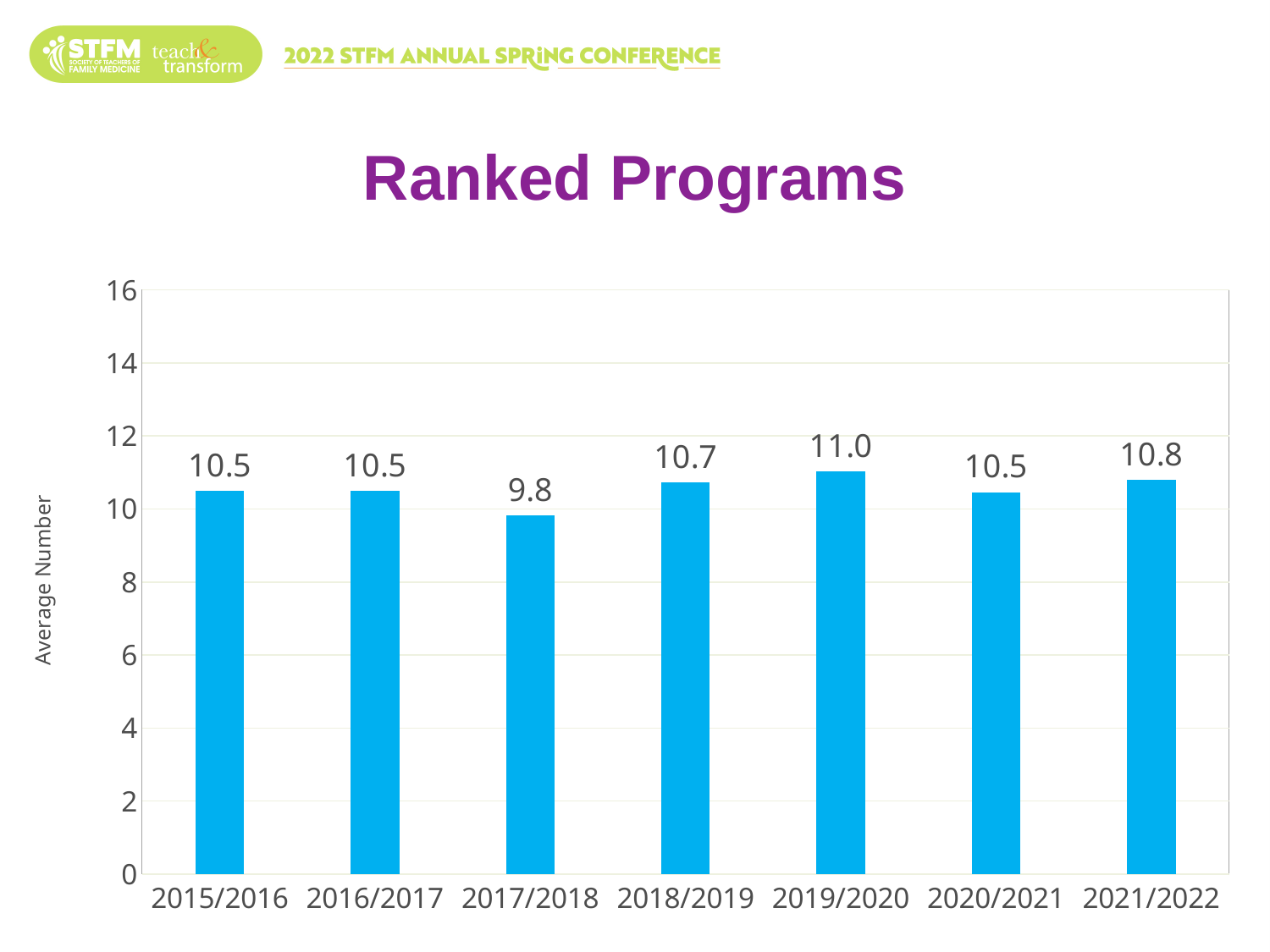
What is the average number of ranked programs for 2017/2018? 9.8 What is the average number of ranked programs for 2019/2020? 11.0 What kind of chart is shown on the slide? bar chart Is the value for 2017/2018 greater or less than 10? less What is the difference between the values for 2021/2022 and 2020/2021? 0.3 Which year has the highest average number of ranked programs? 2019/2020 What is the average number of ranked programs for 2021/2022? 10.8 Which is larger, the value for 2018/2019 or the value for 2017/2018? 2018/2019 Which year has the lowest average number of ranked programs? 2017/2018 What is the title of the chart? Ranked Programs How many years are shown on the x axis? 7 What is the difference between the values for 2019/2020 and 2017/2018? 1.2